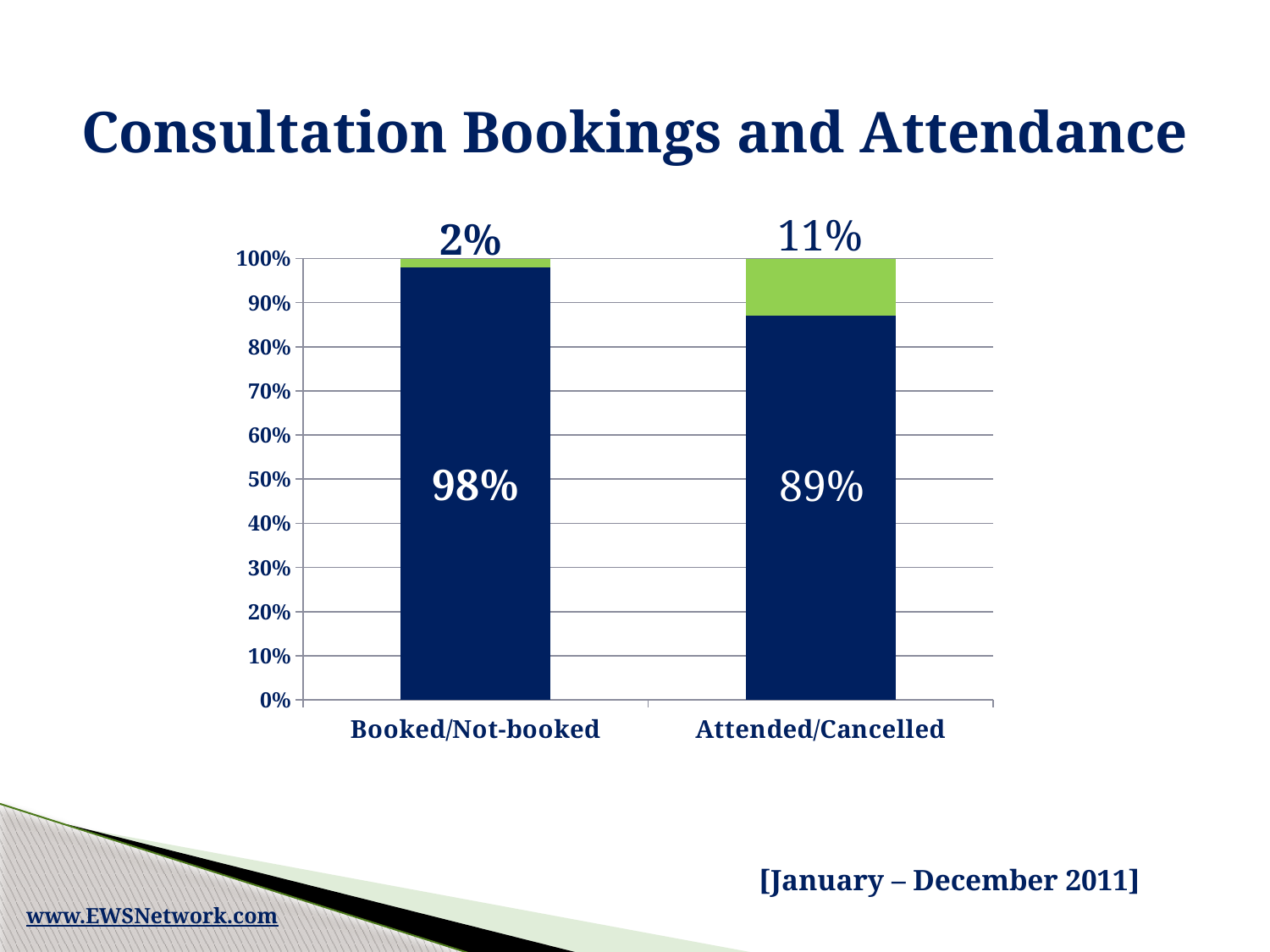
What is the difference between the green segment values of the Attended/Cancelled bar and the Booked/Not-booked bar? 9% How many categories are shown on the x axis of the chart? 2 What is the total of the two segments in the Attended/Cancelled bar? 100% What is the difference between the dark blue segment values of the Booked/Not-booked bar and the Attended/Cancelled bar? 9% What value is shown on the dark blue segment of the Attended/Cancelled bar? 89% What value is shown on the green segment of the Booked/Not-booked bar? 2% What kind of chart is shown on the slide? Stacked bar chart What is the title of the chart on the slide? Consultation Bookings and Attendance What value is shown on the green segment of the Attended/Cancelled bar? 11% What value is shown on the dark blue segment of the Booked/Not-booked bar? 98% Which bar has the larger green segment, Booked/Not-booked or Attended/Cancelled? Attended/Cancelled Which bar has the larger dark blue segment, Booked/Not-booked or Attended/Cancelled? Booked/Not-booked